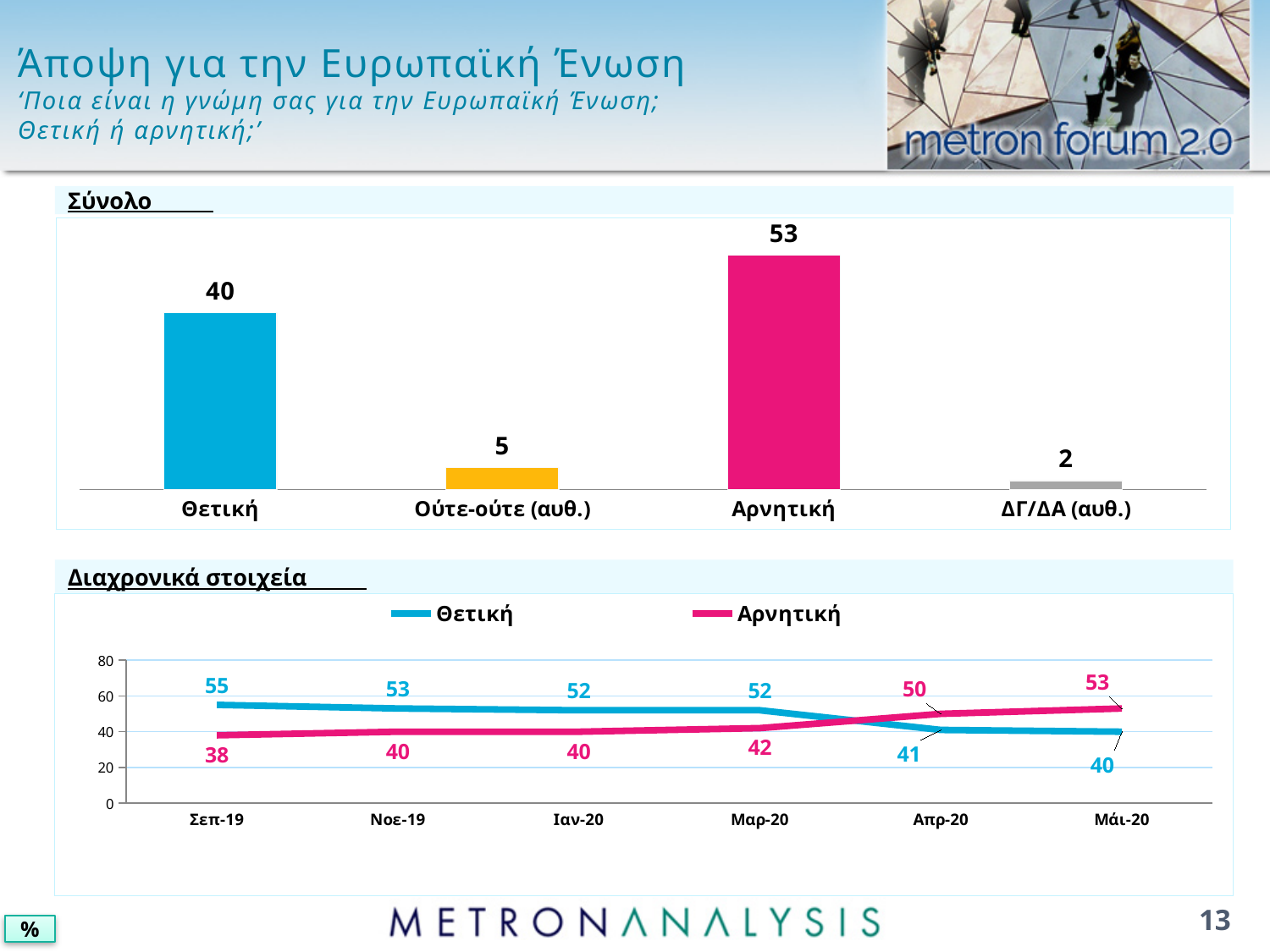
In the 'Σύνολο' bar chart, which category has the lowest value? ΔΓ/ΔΑ (αυθ.) In the 'Σύνολο' bar chart, how many categories are shown? 4 In the 'Διαχρονικά στοιχεία' chart, what is the value for Αρνητική at Απρ-20? 50 What kind of chart is the 'Σύνολο' chart? Bar chart In the 'Διαχρονικά στοιχεία' chart, how many series does the legend list? 2 In the 'Διαχρονικά στοιχεία' chart, what is the value for Θετική at Σεπ-19? 55 In the 'Σύνολο' bar chart, what is the difference between the values for Αρνητική and Θετική? 13 In the 'Διαχρονικά στοιχεία' chart, which is larger at Μαρ-20: Θετική or Αρνητική? Θετική In the 'Σύνολο' bar chart, which category has the highest value? Αρνητική In the 'Διαχρονικά στοιχεία' chart, does the Αρνητική series rise or fall from Σεπ-19 to Μάι-20? Rise In the 'Σύνολο' bar chart, what is the value for Αρνητική? 53 In the 'Σύνολο' bar chart, what is the value for Ούτε-ούτε (αυθ.)? 5